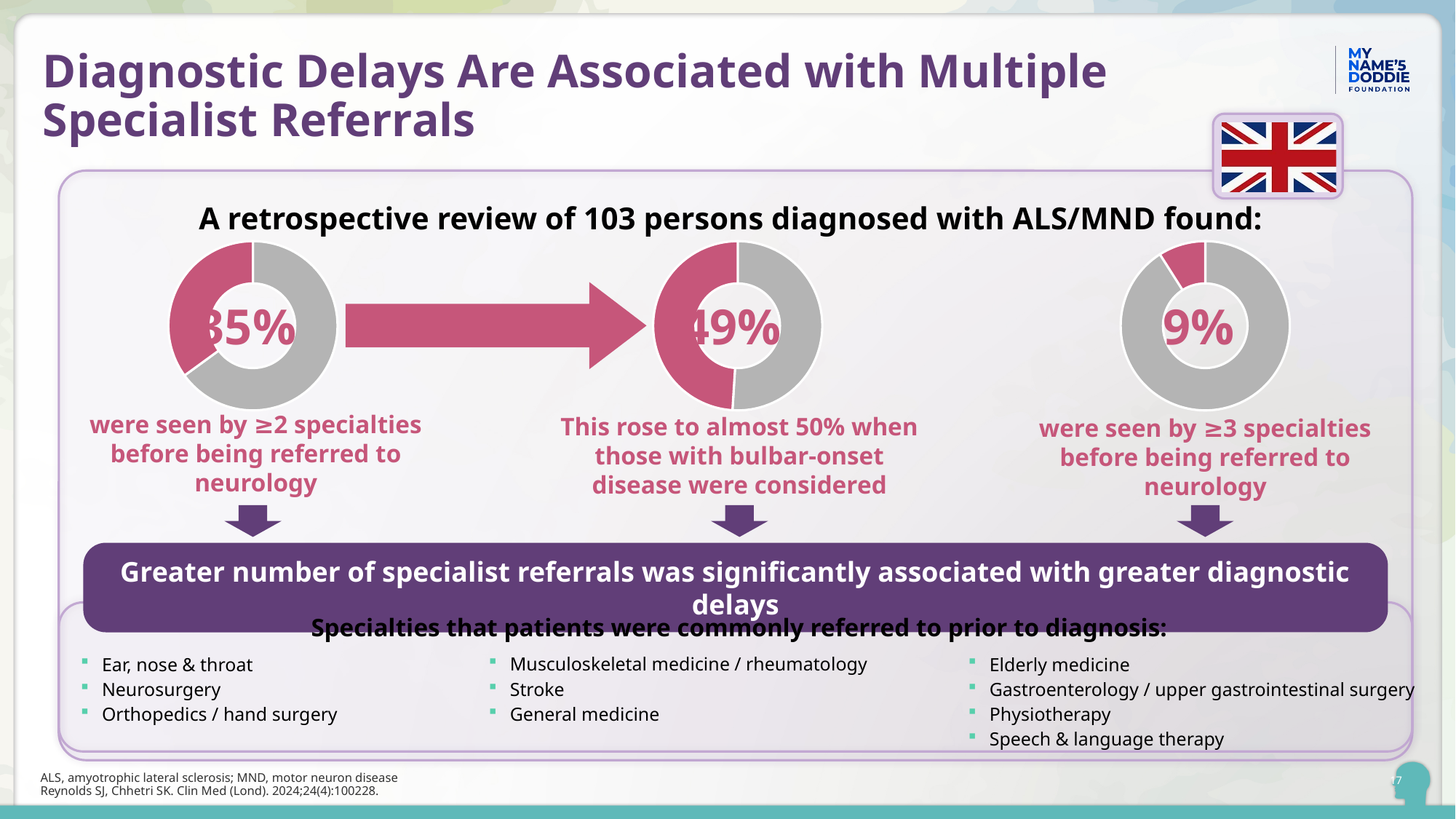
In the left-hand donut chart, what percentage of patients were seen by ≥2 specialties before being referred to neurology? 35% What kind of charts are shown on the slide? Donut charts How many donut charts are shown on the slide? 3 Is the percentage in the middle donut chart greater or less than the percentage in the right-hand donut chart? Greater What colour is used for the highlighted segment in each donut chart? Pink How many persons diagnosed with ALS/MND were included in the retrospective review shown above the donut charts? 103 Which of the three donut charts shows the highest percentage? The middle chart (49%) Which of the three donut charts shows the lowest percentage? The right-hand chart (9%) In the middle donut chart, what percentage is shown when those with bulbar-onset disease were considered? 49% In the right-hand donut chart, what percentage of patients were seen by ≥3 specialties before being referred to neurology? 9% What is the difference between the percentage seen by ≥2 specialties and the percentage seen by ≥3 specialties? 26 percentage points What is the difference between the percentage in the middle donut chart and the percentage in the left-hand donut chart? 14 percentage points